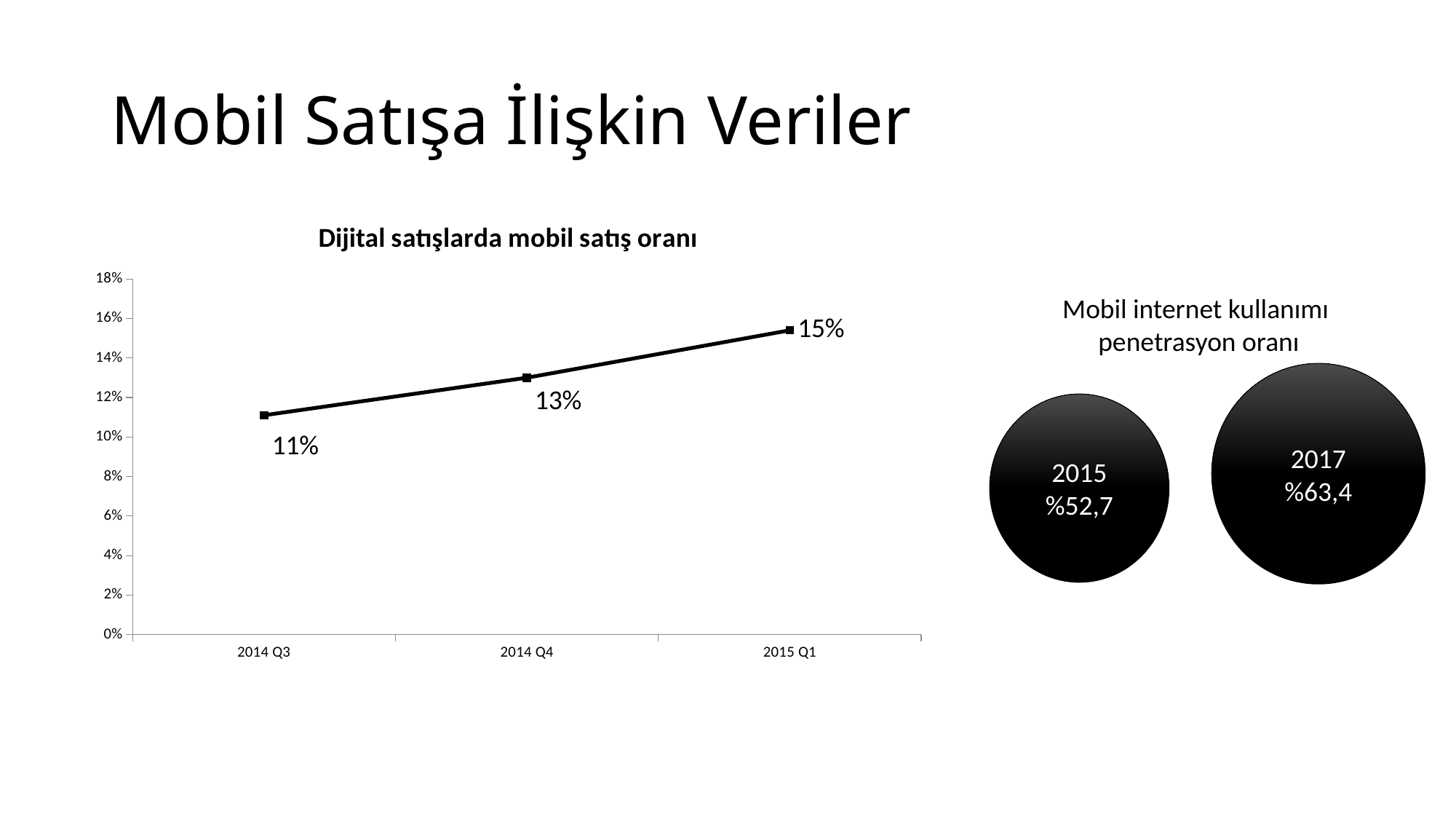
In the chart 'Dijital satışlarda mobil satış oranı', what is the value for 2015 Q1? 15% In the chart 'Dijital satışlarda mobil satış oranı', which period has the highest value? 2015 Q1 In the chart 'Dijital satışlarda mobil satış oranı', what is the difference between the values for 2015 Q1 and 2014 Q3? 4% In the chart 'Dijital satışlarda mobil satış oranı', which is larger, the value for 2014 Q4 or 2014 Q3? 2014 Q4 In the chart 'Dijital satışlarda mobil satış oranı', do the values rise or fall from 2014 Q3 to 2015 Q1? Rise In the chart 'Dijital satışlarda mobil satış oranı', what is the value for 2014 Q4? 13% In the 'Mobil internet kullanımı penetrasyon oranı' graphic on the right, what is the value shown for 2015? %52,7 In the chart 'Dijital satışlarda mobil satış oranı', which period has the lowest value? 2014 Q3 In the 'Mobil internet kullanımı penetrasyon oranı' graphic on the right, what is the value shown for 2017? %63,4 In the chart 'Dijital satışlarda mobil satış oranı', what is the value for 2014 Q3? 11% What kind of chart is 'Dijital satışlarda mobil satış oranı'? Line chart In the chart 'Dijital satışlarda mobil satış oranı', how many data points are plotted? 3